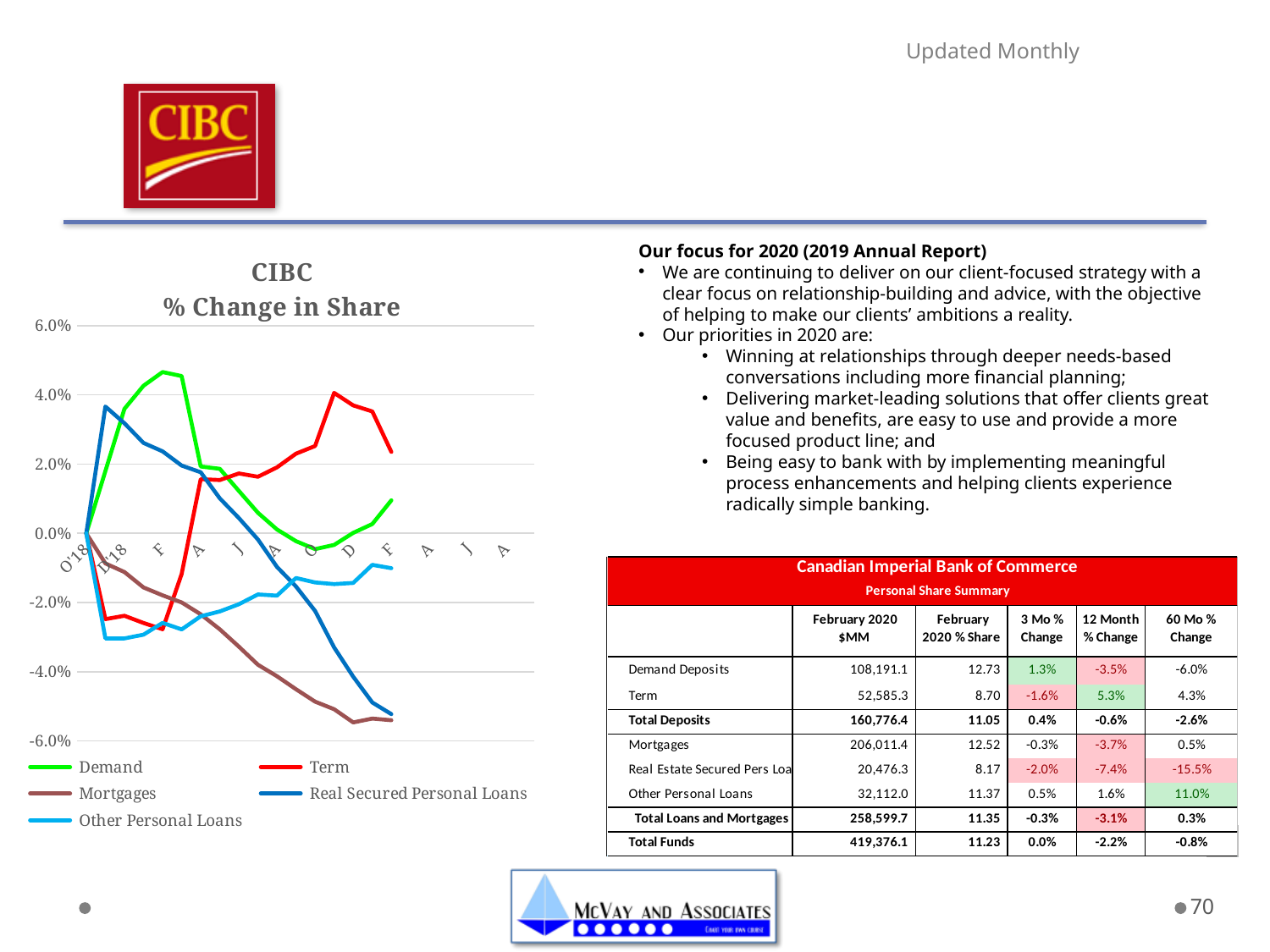
What is the value of the Demand series at O'18, the first point on the x axis? 0.0% What kind of chart is shown on the slide? line chart Which colour is used for the Demand series in the chart? green Which series has the highest value at the last plotted point? Term What is the title of the chart? CIBC % Change in Share Is the final value of the Mortgages series greater or less than -4.0%? less Does the Mortgages series generally rise or fall across the x axis? fall At the last plotted point, which series is higher, Demand or Mortgages? Demand Is the value of the Term series at D'18 greater or less than -2.0%? less Which series reaches the highest value anywhere on the chart? Demand How many series does the legend of the chart list? 5 Is the peak value of the Demand series greater or less than 4.0%? greater